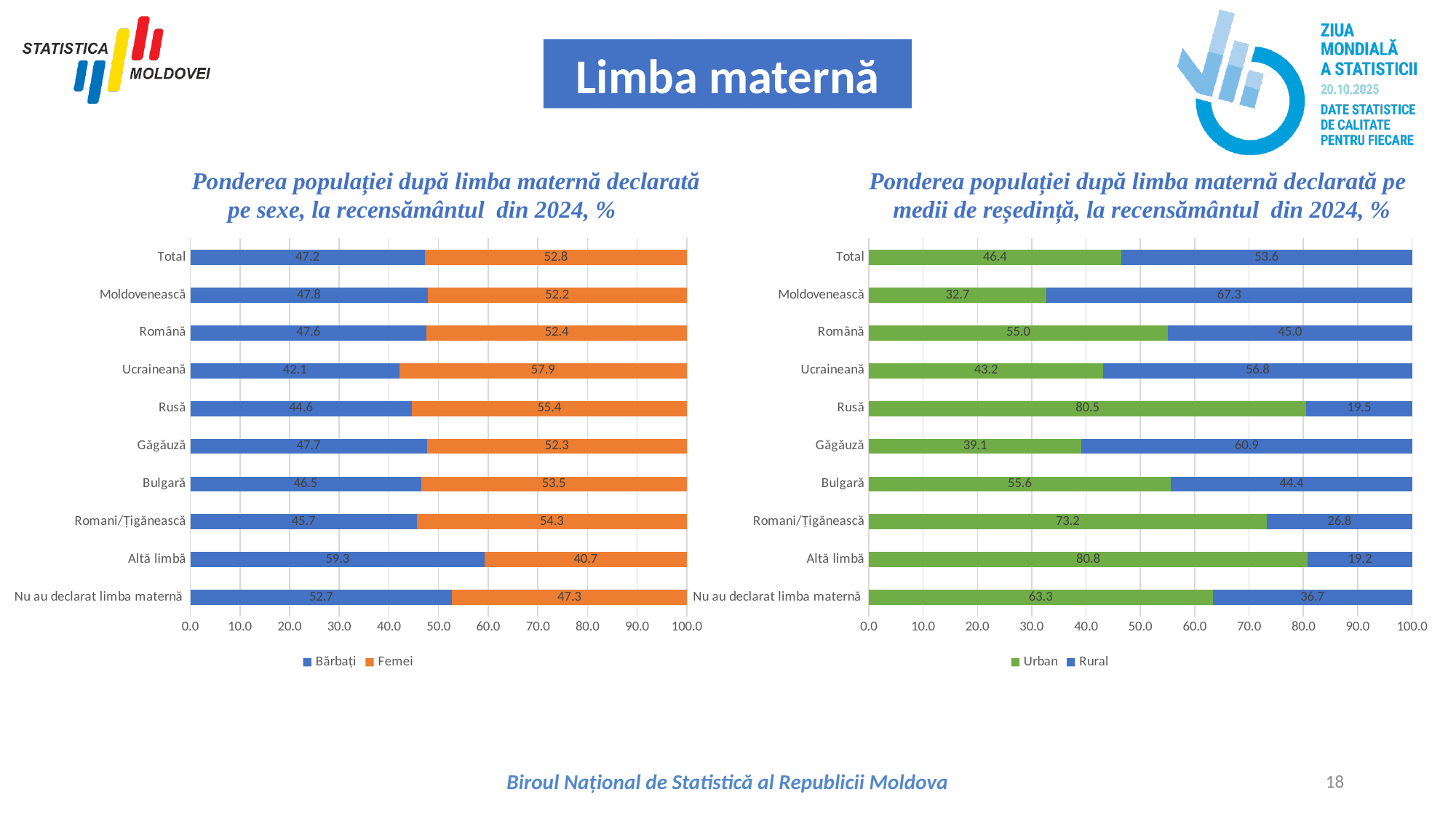
In the right chart (by residence), what is the difference between the Urban and Rural values for Română? 10.0 In the left chart (by sex), is the Femei value larger for Ucraineană or for Rusă? Ucraineană In the right chart (by residence), which category has the highest Rural value? Moldovenească How many series does the legend of the right chart (by residence) list? 2 What type of chart is the right chart (by residence)? Stacked bar chart In the left chart (by sex), what is the Bărbați value for Ucraineană? 42.1 In the left chart (by sex), which category has the highest Bărbați value? Altă limbă How many categories are shown in the left chart (by sex)? 10 In the right chart (by residence), what is the Urban value for Rusă? 80.5 In the right chart (by residence), what is the total of the stacked bar for Bulgară? 100.0 In the left chart (by sex), what is the Femei value for Altă limbă? 40.7 In the right chart (by residence), which category has the lowest Urban value? Moldovenească